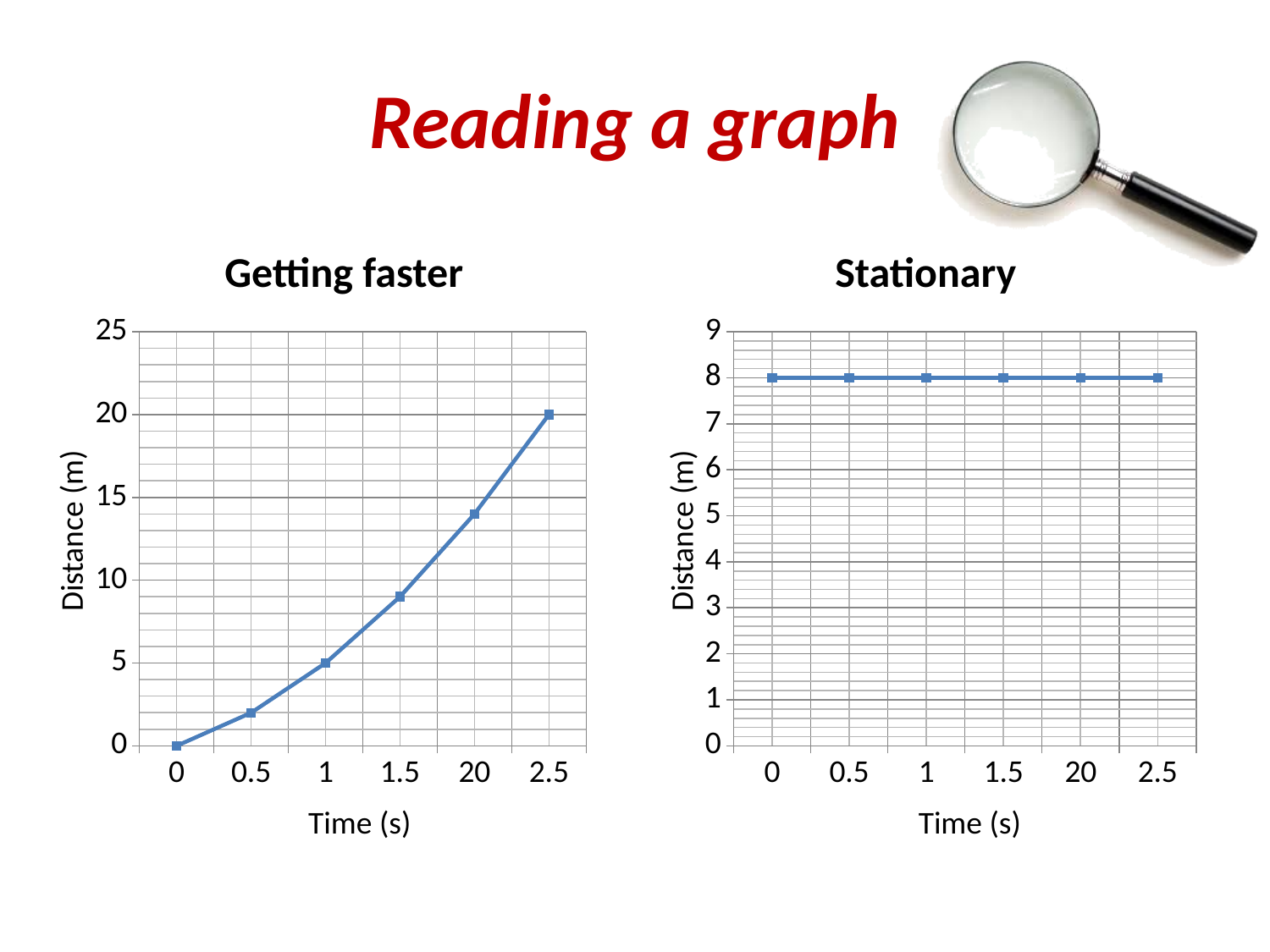
In the "Stationary" chart, what is the distance at time 1 s? 8 In the "Getting faster" chart, is the distance at time 0.5 s greater or less than 5? less In the "Stationary" chart, do the values rise, fall or stay flat as time increases? stay flat How many data points are plotted in the "Getting faster" chart? 6 In the "Getting faster" chart, what is the difference between the distance at 2.5 s and the distance at 1 s? 15 In the "Getting faster" chart, what is the distance at time 1 s? 5 In the "Getting faster" chart, do the values rise or fall as time increases? rise What is the y-axis label of the "Stationary" chart? Distance (m) What kind of chart is the "Getting faster" chart? line chart In the "Getting faster" chart, at which time is the distance highest? 2.5 In the "Getting faster" chart, what is the distance at time 2.5 s? 20 In the "Getting faster" chart, what is the distance at time 0 s? 0